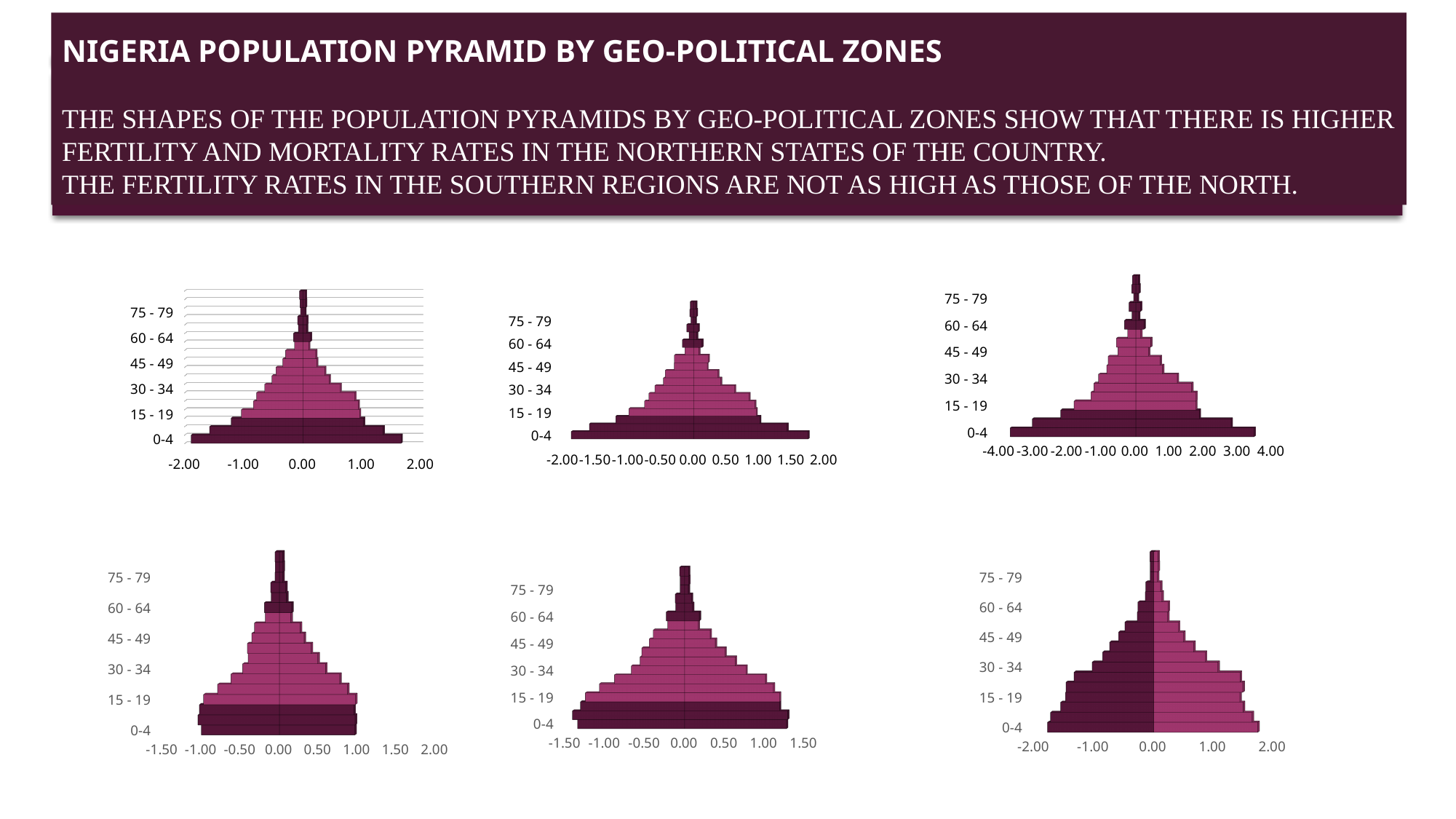
In the top-right chart, which labelled age group has the longest bars? 0-4 In the bottom-right chart, is the right-hand bar for the 0-4 age group greater or less than 1.00? greater What kind of chart is the top-left chart on the slide? bar chart In the bottom-left chart, what is the lowest value shown on the horizontal axis? -1.50 In the bottom-left chart, do the bar lengths increase or decrease as the age group rises from 0-4 to 75-79? decrease In the top-right chart, is the right-hand bar for the 0-4 age group greater or less than 3.00? greater In the top-left chart, is the right-hand bar for the 75-79 age group greater or less than 1.00? less In the top-right chart, what is the highest value shown on the horizontal axis? 4.00 How many population pyramid charts are shown on the slide? 6